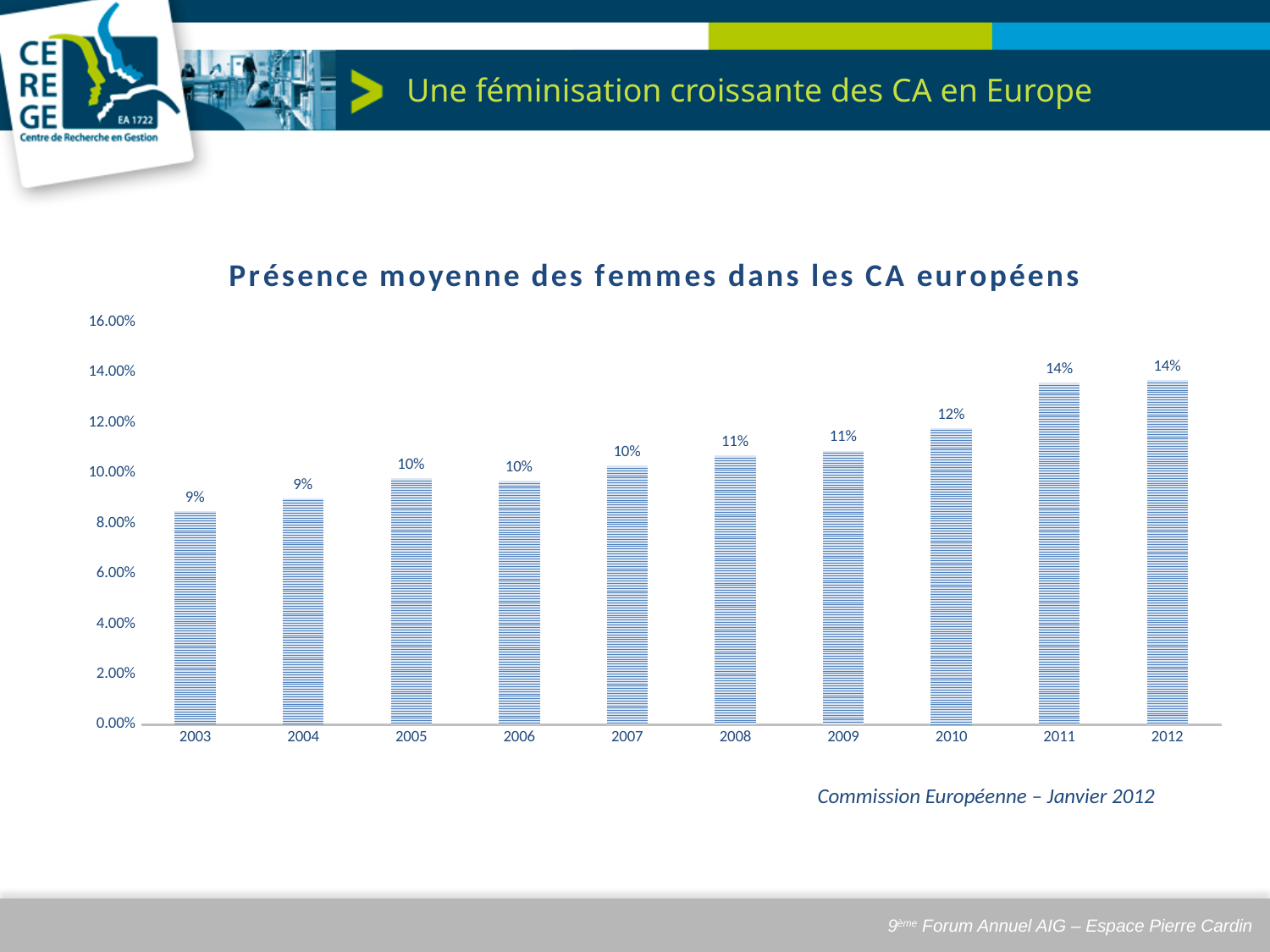
Which year has the larger value, 2005 or 2010? 2010 What is the value shown for 2010? 12% How many years are shown on the x axis? 10 Is the value for 2003 greater or less than 10.00%? less What is the highest value labelled on the chart? 14% What type of chart is shown on the slide? Bar chart What is the difference between the value for 2012 and the value for 2003? 5 percentage points What is the title of the chart? Présence moyenne des femmes dans les CA européens What is the value shown for 2003? 9% What is the lowest value labelled on the chart? 9% What is the value shown for 2008? 11% Do the values generally rise or fall from 2003 to 2012? Rise